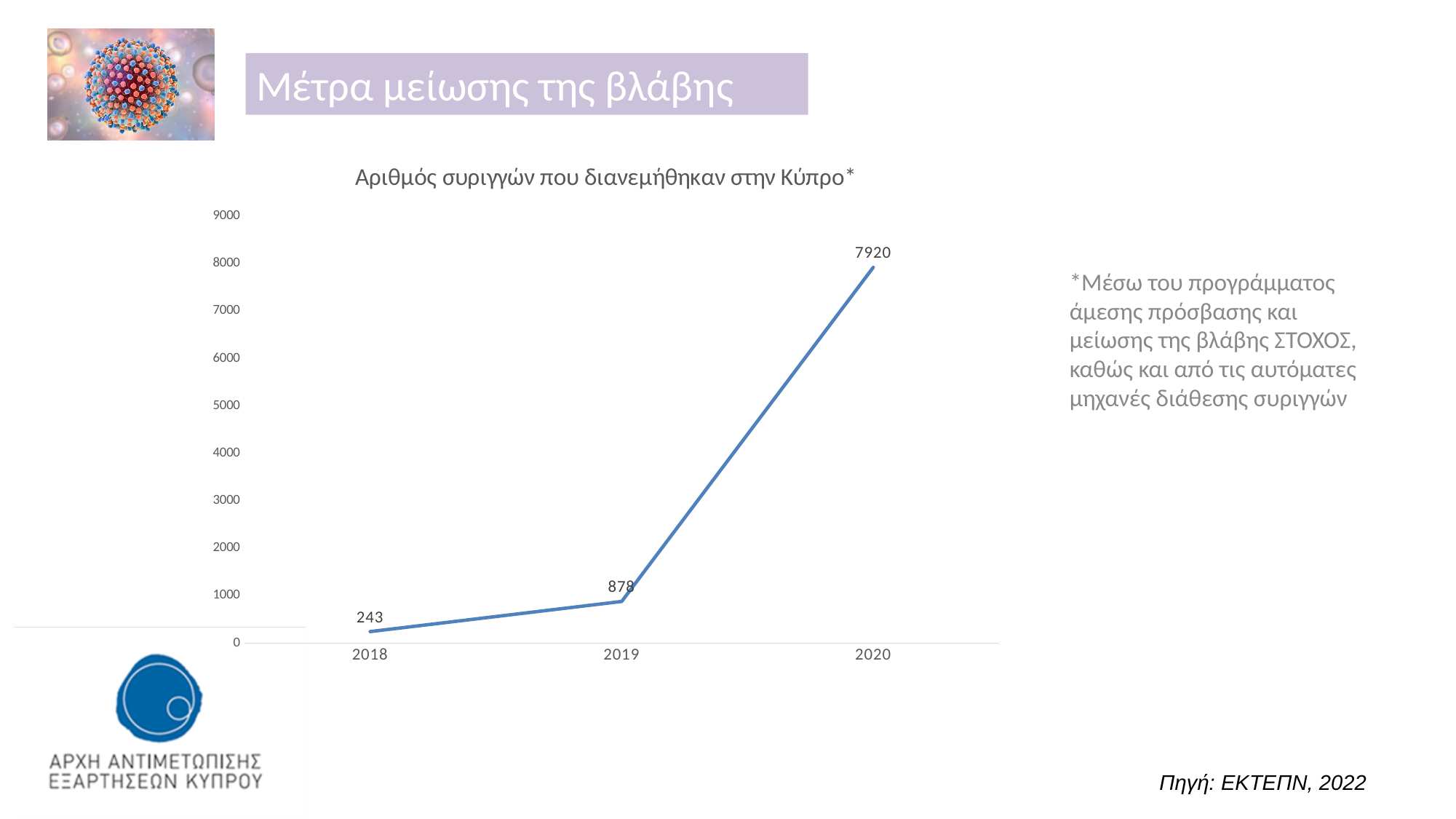
What is the difference between the number of syringes distributed in 2019 and in 2018? 635 What is the number of syringes distributed in Cyprus in 2020? 7920 Which year has the highest number of syringes distributed? 2020 How many years are shown on the x axis of the chart? 3 Which year has the lowest number of syringes distributed? 2018 What kind of chart is shown on the slide? line chart Is the value for 2020 greater or less than 7000? greater Do the values rise or fall from 2018 to 2020? rise What is the number of syringes distributed in Cyprus in 2018? 243 What is the difference between the number of syringes distributed in 2020 and in 2019? 7042 Which year had more syringes distributed, 2018 or 2019? 2019 What is the number of syringes distributed in Cyprus in 2019? 878